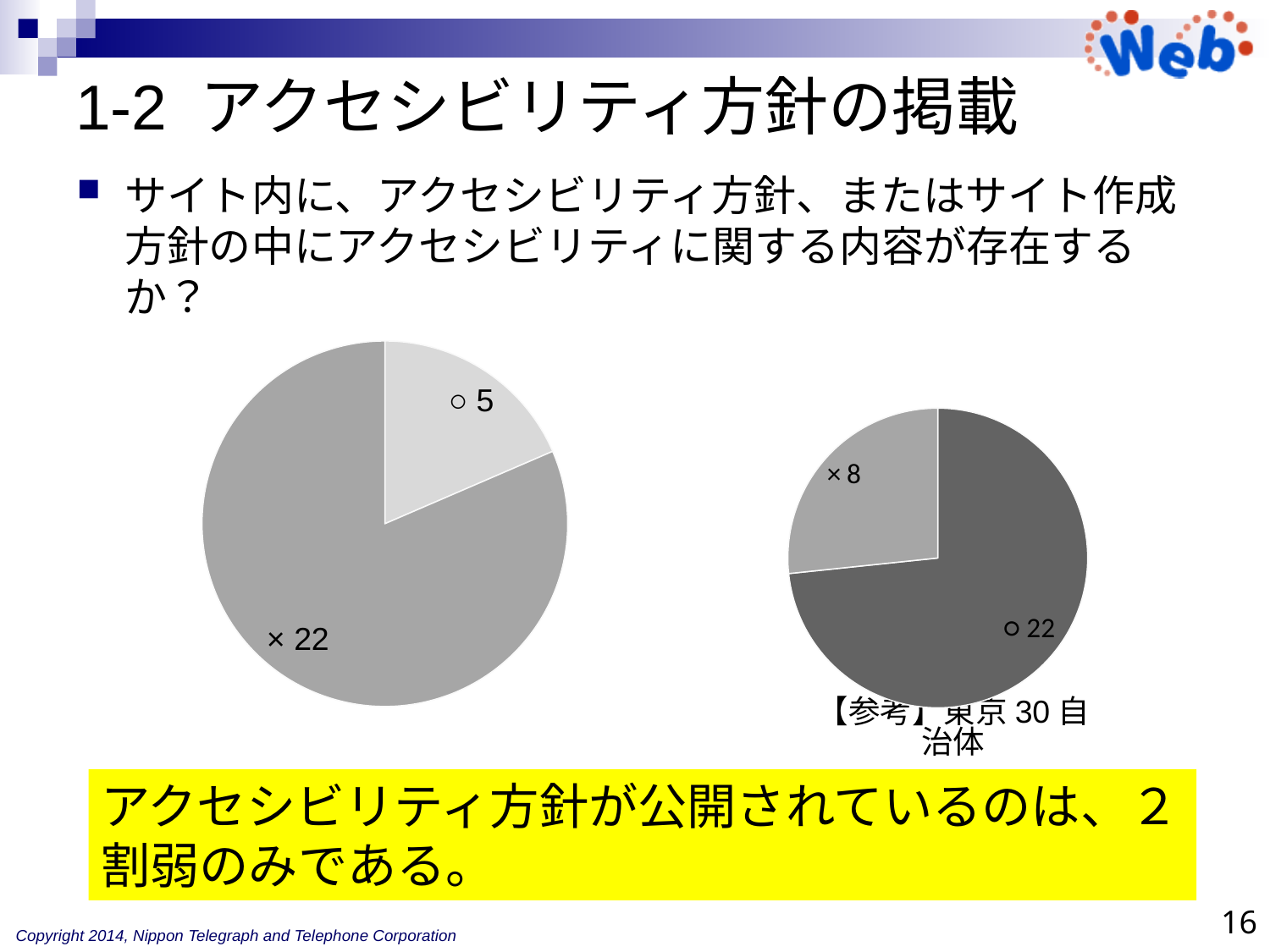
In the left pie chart, what is the value for ○? 5 What is the total of the two values shown in the left pie chart? 27 In the left pie chart, what is the value for ×? 22 In the left pie chart, what is the difference between the × value and the ○ value? 17 In the left pie chart, which is larger, ○ or ×? × What kind of chart is the left chart on the slide? pie chart In the right pie chart (【参考】東京30自治体), what is the difference between the ○ value and the × value? 14 How many slices does the right pie chart (【参考】東京30自治体) have? 2 In the right pie chart (【参考】東京30自治体), which category has the smallest slice? × In the right pie chart (【参考】東京30自治体), what is the value for ○? 22 In the left pie chart, which category has the largest slice? × In the right pie chart (【参考】東京30自治体), what is the value for ×? 8